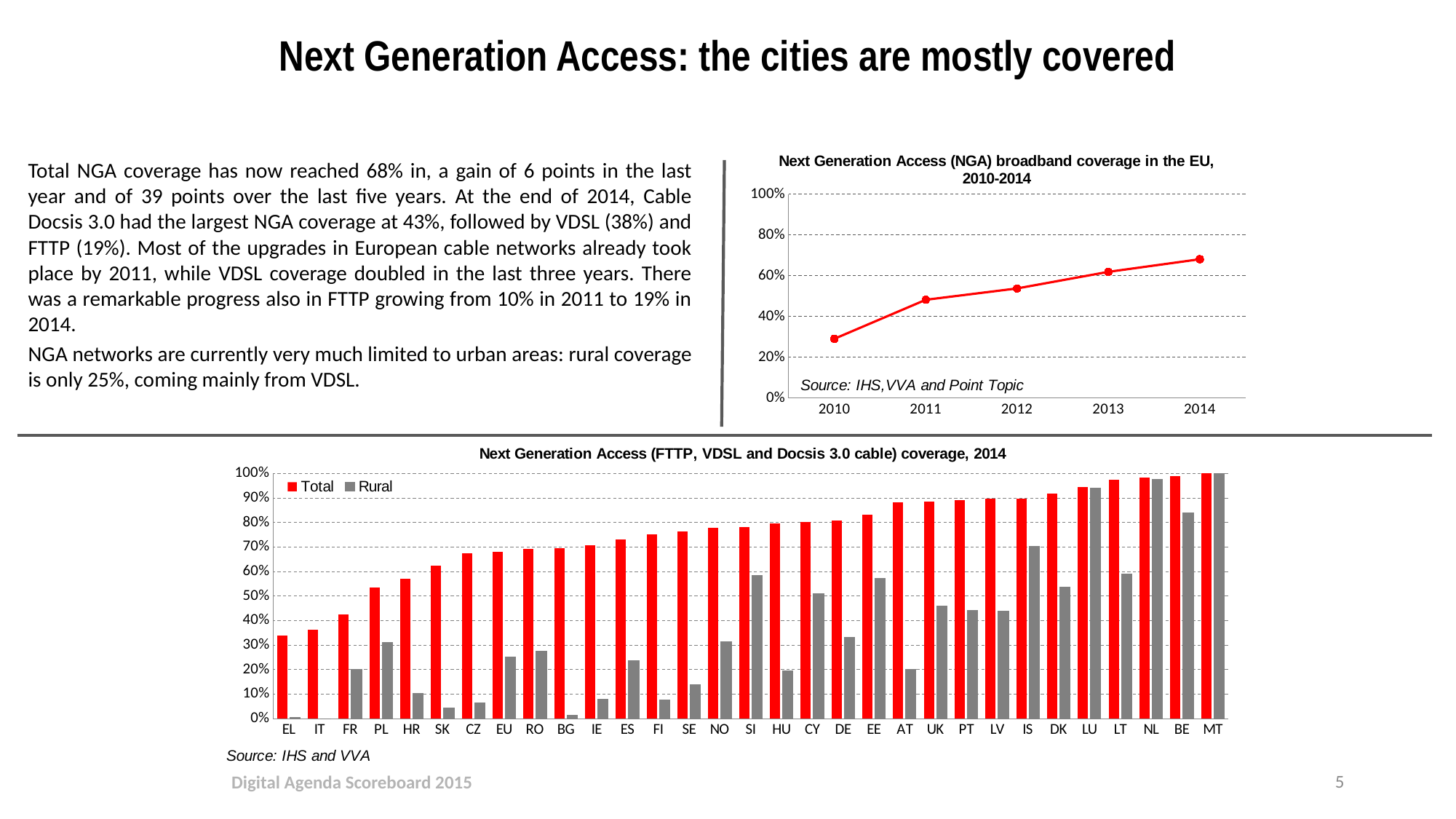
In the top-right line chart, is the value for 2010 greater or less than 40%? less In the bottom bar chart, how many series does the legend list? 2 What kind of chart is the top-right chart titled "Next Generation Access (NGA) broadband coverage in the EU, 2010-2014"? line chart In the bottom bar chart, which is larger: the Rural value for SI or the Rural value for HU? SI In the bottom bar chart, is the Total value for PL greater or less than 50%? greater In the bottom bar chart, what colour are the Rural bars? grey In the top-right line chart, how many years are plotted on the x axis? 5 In the bottom bar chart, which country has the lowest Total coverage? EL In the top-right line chart, is the value for 2014 greater or less than 60%? greater What kind of chart is the bottom chart titled "Next Generation Access (FTTP, VDSL and Docsis 3.0 cable) coverage, 2014"? bar chart In the top-right line chart, do the values rise or fall from 2010 to 2014? rise In the bottom bar chart, which country has the highest Rural coverage? MT